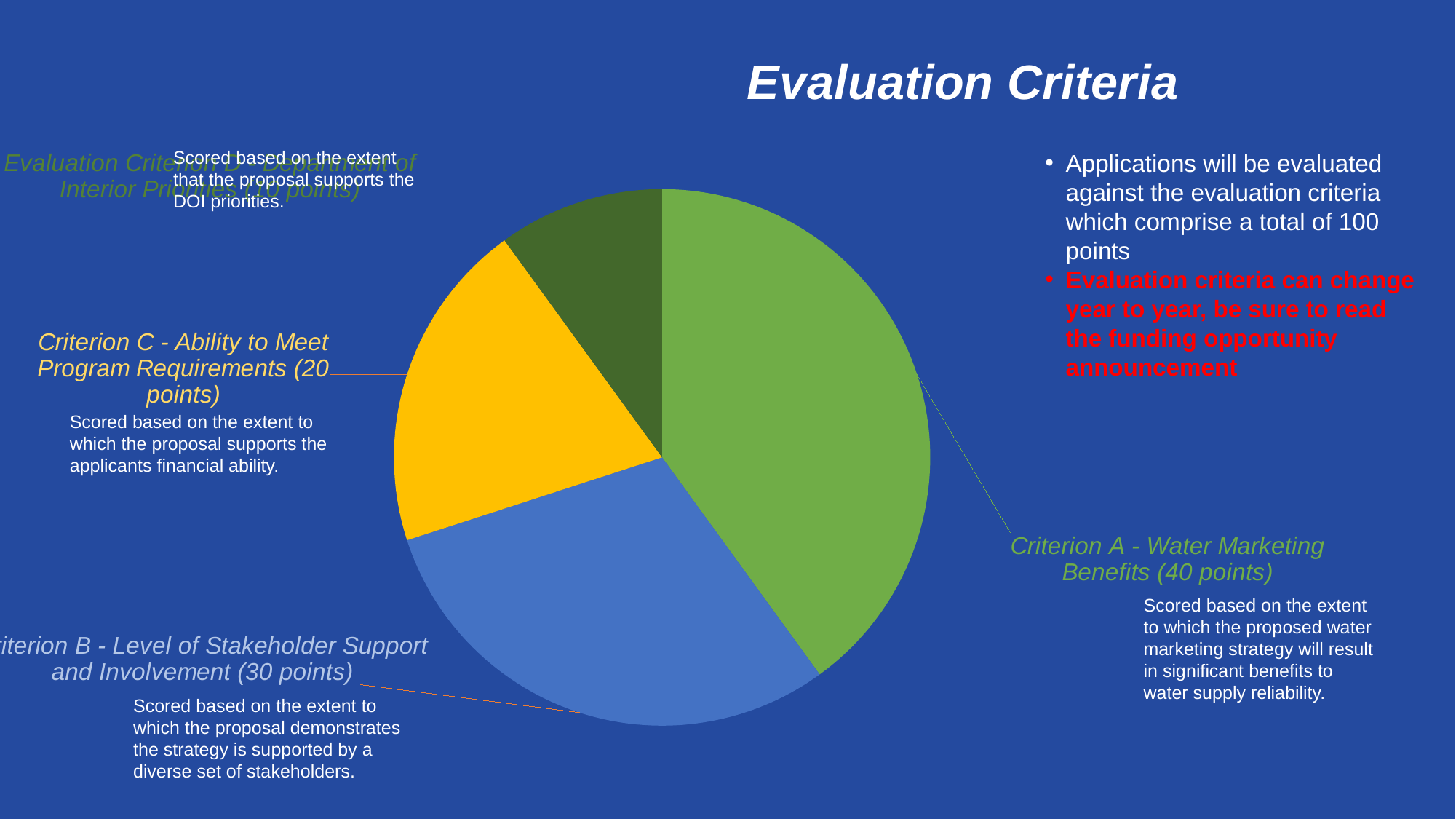
Which criterion has the largest slice of the pie chart? Criterion A - Water Marketing Benefits How many slices does the pie chart have? 4 What share of the total 100 points does Criterion A represent? 40% Which is worth more points, Criterion B or Criterion C? Criterion B What colour is the slice for Criterion C - Ability to Meet Program Requirements? yellow What kind of chart is shown on the slide? pie chart What is the difference in points between Criterion A and Criterion C? 20 points Which criterion has the smallest slice of the pie chart? Criterion D - Department of Interior Priorities How many points is Criterion A - Water Marketing Benefits worth? 40 points How many points is Criterion C - Ability to Meet Program Requirements worth? 20 points What is the title of the slide containing the pie chart? Evaluation Criteria How many points is Criterion B - Level of Stakeholder Support and Involvement worth? 30 points